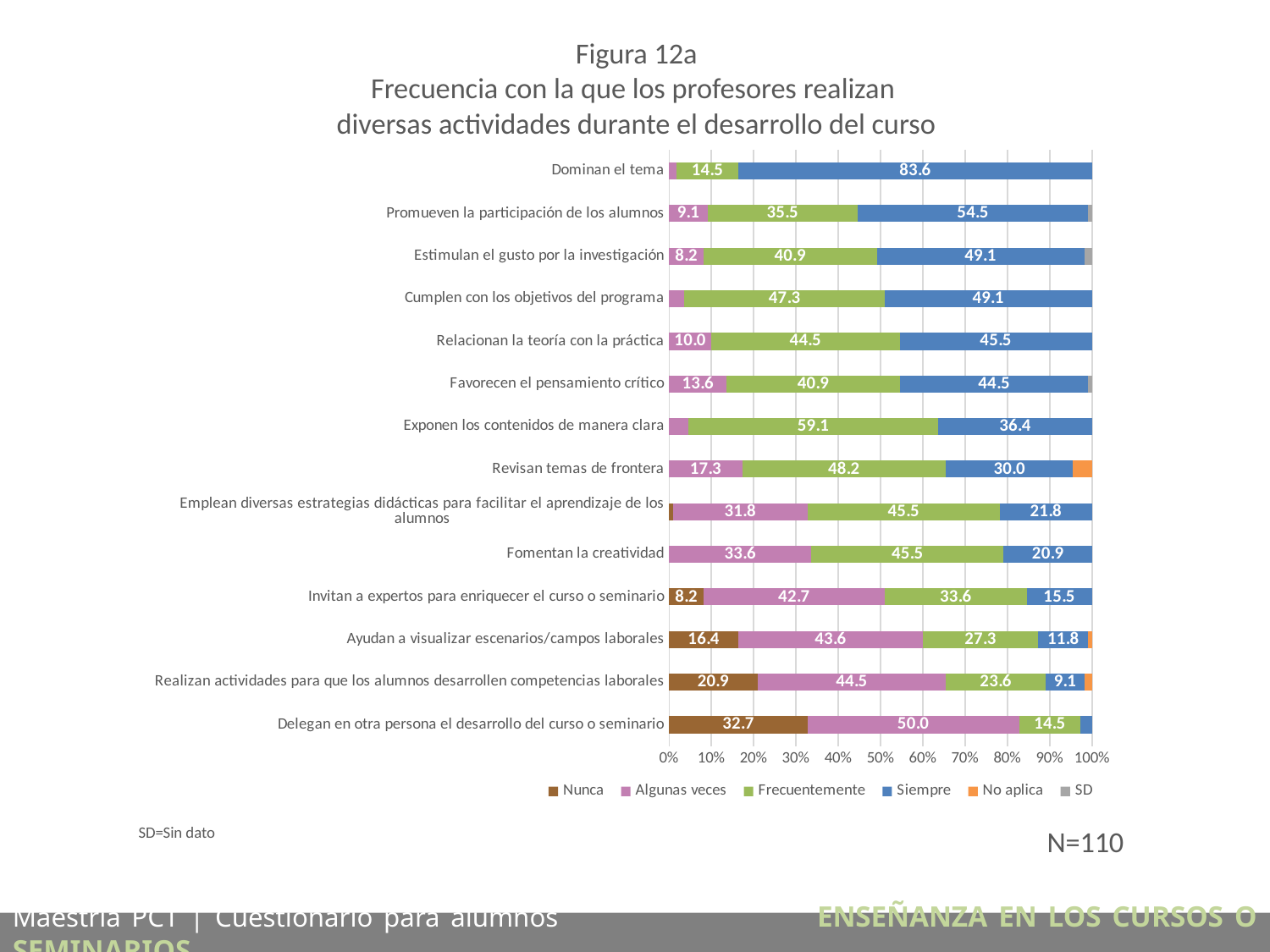
Which category has the highest 'Siempre' value? Dominan el tema How many series does the legend list? 6 What is the figure number given in the chart title? Figura 12a Which is larger: the 'Algunas veces' value for 'Fomentan la creatividad' or for 'Revisan temas de frontera'? Fomentan la creatividad How many activity categories are plotted on the chart? 14 What is the 'Siempre' value for 'Dominan el tema'? 83.6 What is the 'Nunca' value for 'Delegan en otra persona el desarrollo del curso o seminario'? 32.7 What type of chart is shown on the slide? Stacked bar chart Which category has the highest 'Nunca' value? Delegan en otra persona el desarrollo del curso o seminario What is the difference between the 'Siempre' values for 'Promueven la participación de los alumnos' and 'Estimulan el gusto por la investigación'? 5.4 What is the 'Frecuentemente' value for 'Exponen los contenidos de manera clara'? 59.1 What is the 'Siempre' value for 'Realizan actividades para que los alumnos desarrollen competencias laborales'? 9.1